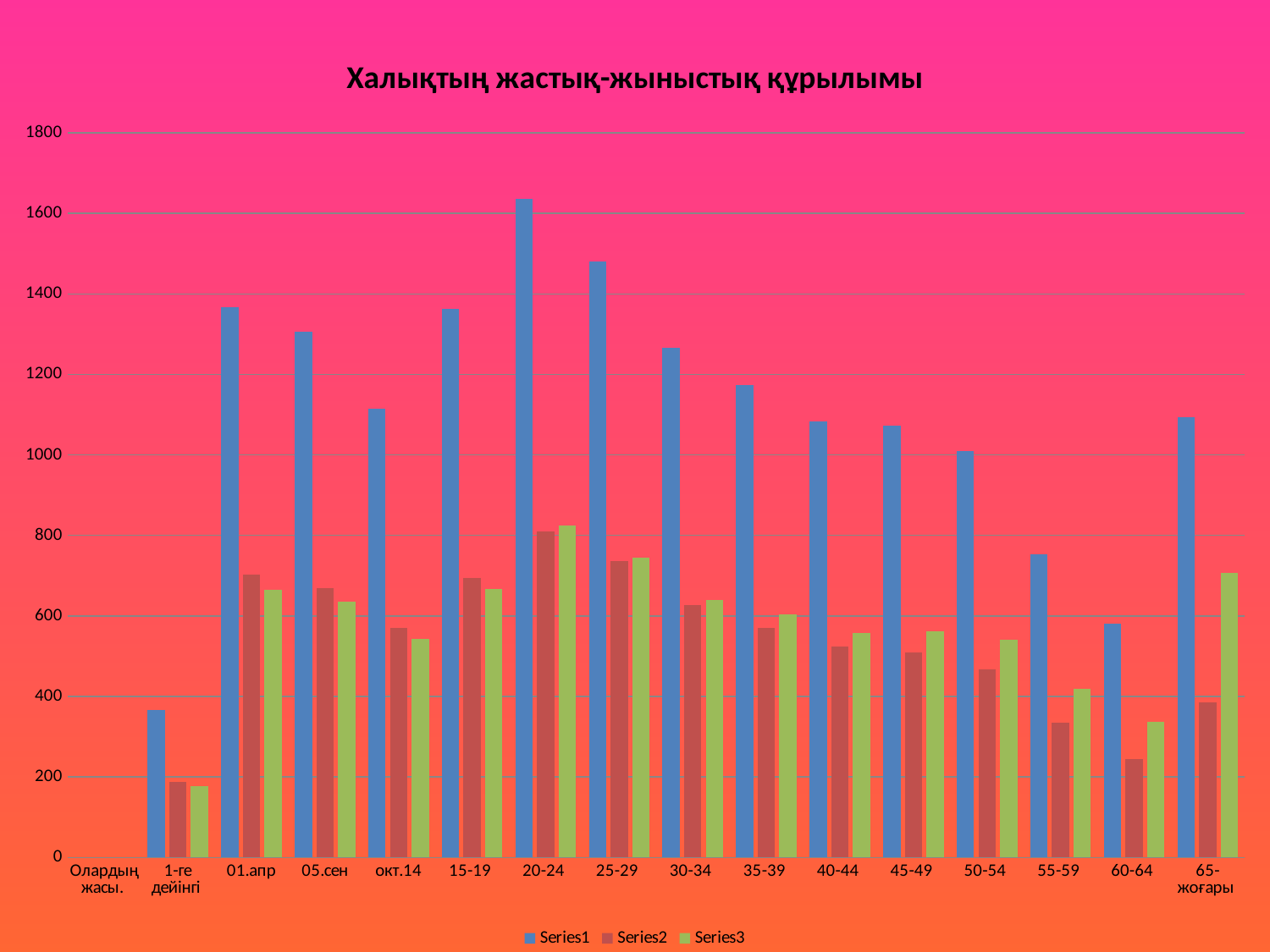
Which is larger for 65-жоғары, the Series2 value or the Series3 value? Series3 Is the Series1 value for 1-ге дейінгі greater or less than 400? less What is the title of the chart? Халықтың жастық-жыныстық құрылымы For which category is the Series1 value lowest? 1-ге дейінгі For which category is the Series3 value highest? 20-24 What kind of chart is shown on the slide? bar chart How many series does the legend list? 3 Do the Series1 values rise or fall from 20-24 to 60-64? fall Is the Series1 value for 20-24 greater or less than 1400? greater For which category is the Series1 value highest? 20-24 Is the Series3 value for 65-жоғары greater or less than 600? greater